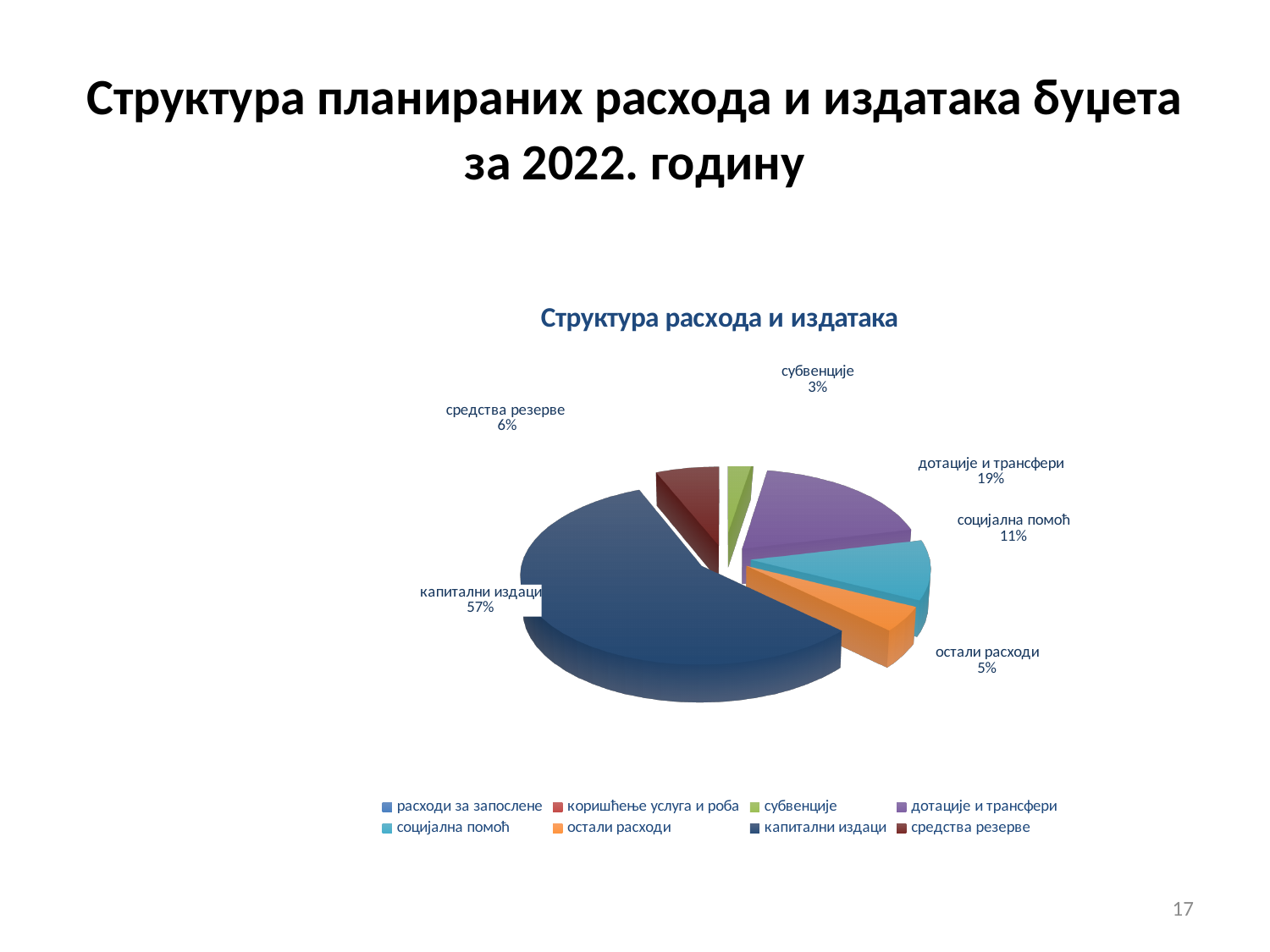
Which is larger, социјална помоћ or остали расходи? социјална помоћ How many entries does the legend list? 8 What is the value shown for дотације и трансфери? 19% What is the value shown for средства резерве? 6% What is the title of the chart? Структура расхода и издатака What share of the pie does капитални издаци represent? 57% What is the difference in percentage points between капитални издаци and дотације и трансфери? 38 What is the value shown for социјална помоћ? 11% What is the value shown for субвенције? 3% Which category has the largest slice of the pie? капитални издаци Which labelled category has the smallest slice of the pie? субвенције What kind of chart is shown on the slide? pie chart